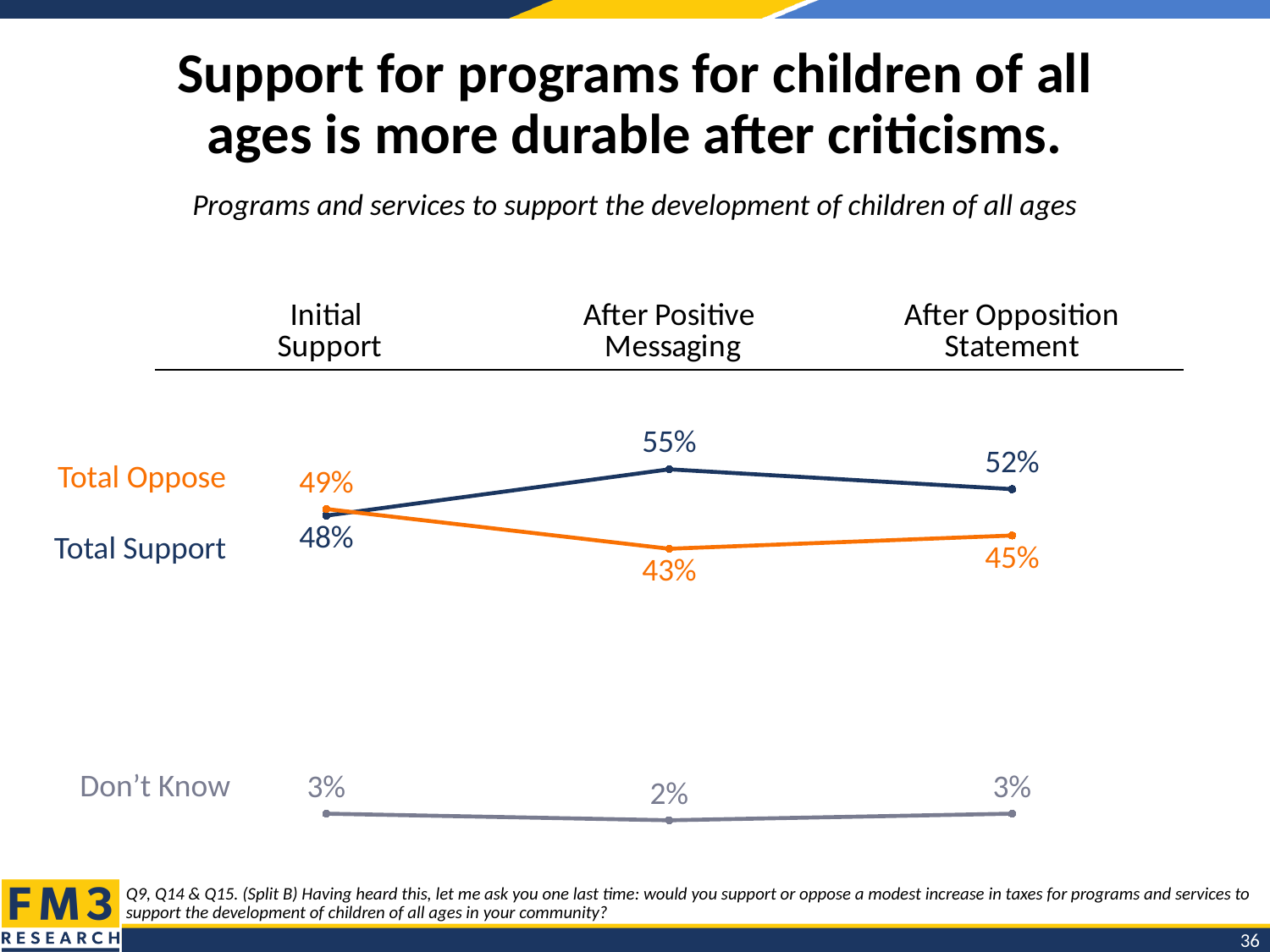
At which stage is Total Support highest? After Positive Messaging What is the Don't Know value after positive messaging? 2% What is the Total Support value after positive messaging? 55% What is the Total Oppose value after the opposition statement? 45% What kind of chart is shown on the slide? Line chart At which stage is Total Oppose lowest? After Positive Messaging Does Total Oppose rise or fall from the initial support stage to after positive messaging? Fall How many stages are shown along the x axis? 3 What is the difference between Total Support and Total Oppose after the opposition statement? 7 percentage points How many series are plotted on the chart? 3 Which is larger at the initial support stage, Total Support or Total Oppose? Total Oppose What is the Total Oppose value at the initial support stage? 49%